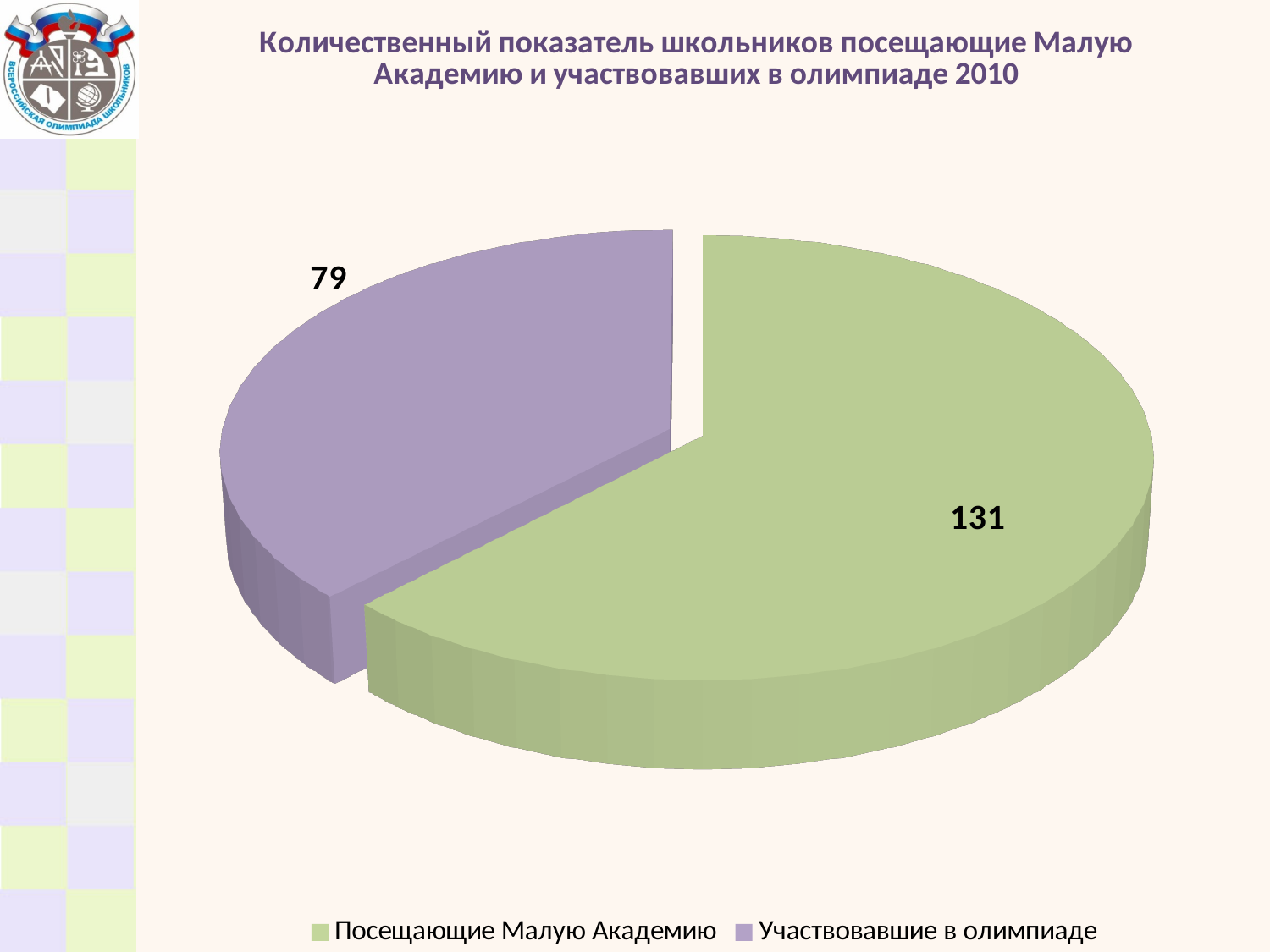
Which category has the largest slice of the pie? Посещающие Малую Академию What colour is the slice for Участвовавшие в олимпиаде? Purple How many slices does the pie chart have? 2 Which category has the smallest slice of the pie? Участвовавшие в олимпиаде How many entries does the legend list? 2 What is the value for Участвовавшие в олимпиаде? 79 What is the value for Посещающие Малую Академию? 131 Which is larger: the value for Посещающие Малую Академию or the value for Участвовавшие в олимпиаде? Посещающие Малую Академию What is the title of the chart? Количественный показатель школьников посещающие Малую Академию и участвовавших в олимпиаде 2010 What is the total of all slices in the pie chart? 210 What is the difference between the value for Посещающие Малую Академию and the value for Участвовавшие в олимпиаде? 52 What type of chart is shown on the slide? Pie chart